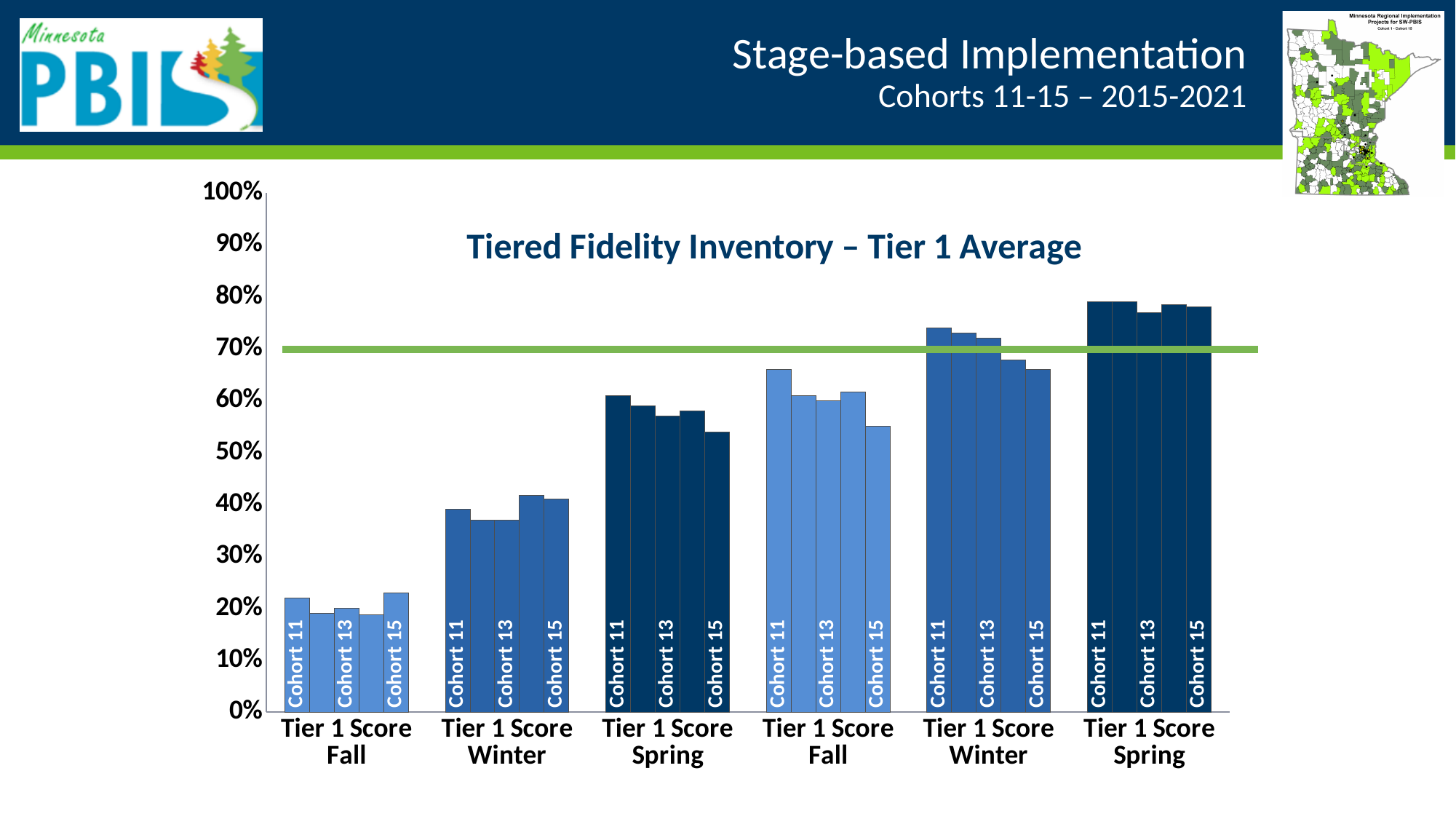
Is the value for Cohort 15 in the first Tier 1 Score Spring group greater or less than 50%? greater Is the value for Cohort 11 in the second Tier 1 Score Spring group greater or less than 80%? less Is the value for Cohort 13 in the first Tier 1 Score Winter group greater or less than 40%? less What kind of chart is shown on the slide? bar chart What is the title of the chart? Tiered Fidelity Inventory – Tier 1 Average Which Tier 1 Score group has the highest bars overall? the second Tier 1 Score Spring group Which Tier 1 Score group has the lowest bars overall? the first Tier 1 Score Fall group At what percentage level is the horizontal green line drawn? 70% In the first Tier 1 Score Spring group, which is larger: the value for Cohort 11 or the value for Cohort 15? Cohort 11 How many Tier 1 Score groups are shown along the x axis? 6